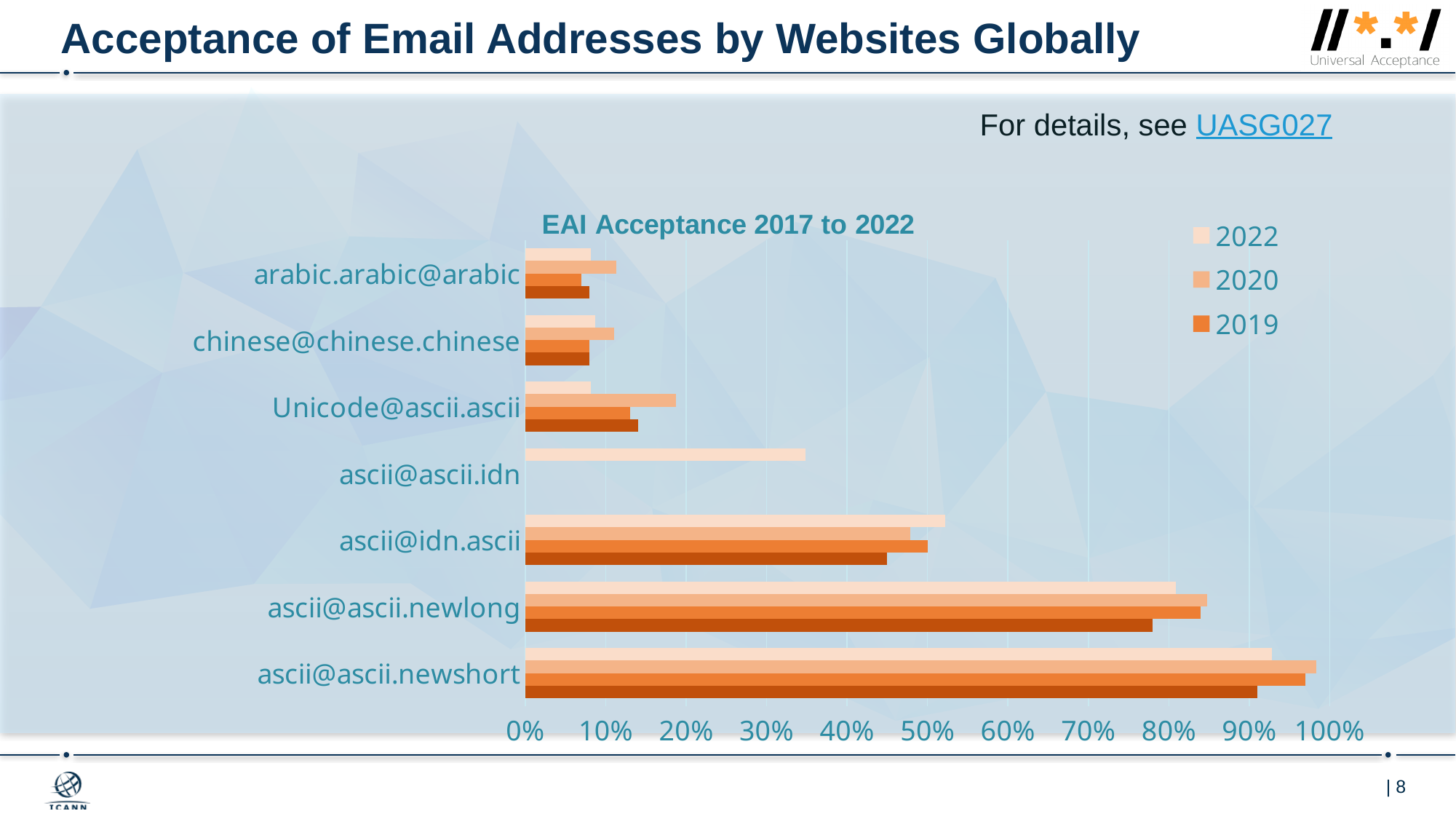
What is the title of the chart? EAI Acceptance 2017 to 2022 What kind of chart is shown on the slide? bar chart Which years are listed in the legend? 2022, 2020, 2019 How many email address categories are shown on the y axis? 7 For ascii@idn.ascii, which is larger: the 2022 value or the 2019 value? 2022 Is the 2020 value for Unicode@ascii.ascii greater or less than 10%? greater Is the 2019 value for ascii@ascii.newlong greater or less than 80%? greater Is the 2022 value for ascii@ascii.idn greater or less than 30%? greater How many series does the legend list? 3 Which category has the highest 2019 value? ascii@ascii.newshort Which category has the highest 2022 value? ascii@ascii.newshort